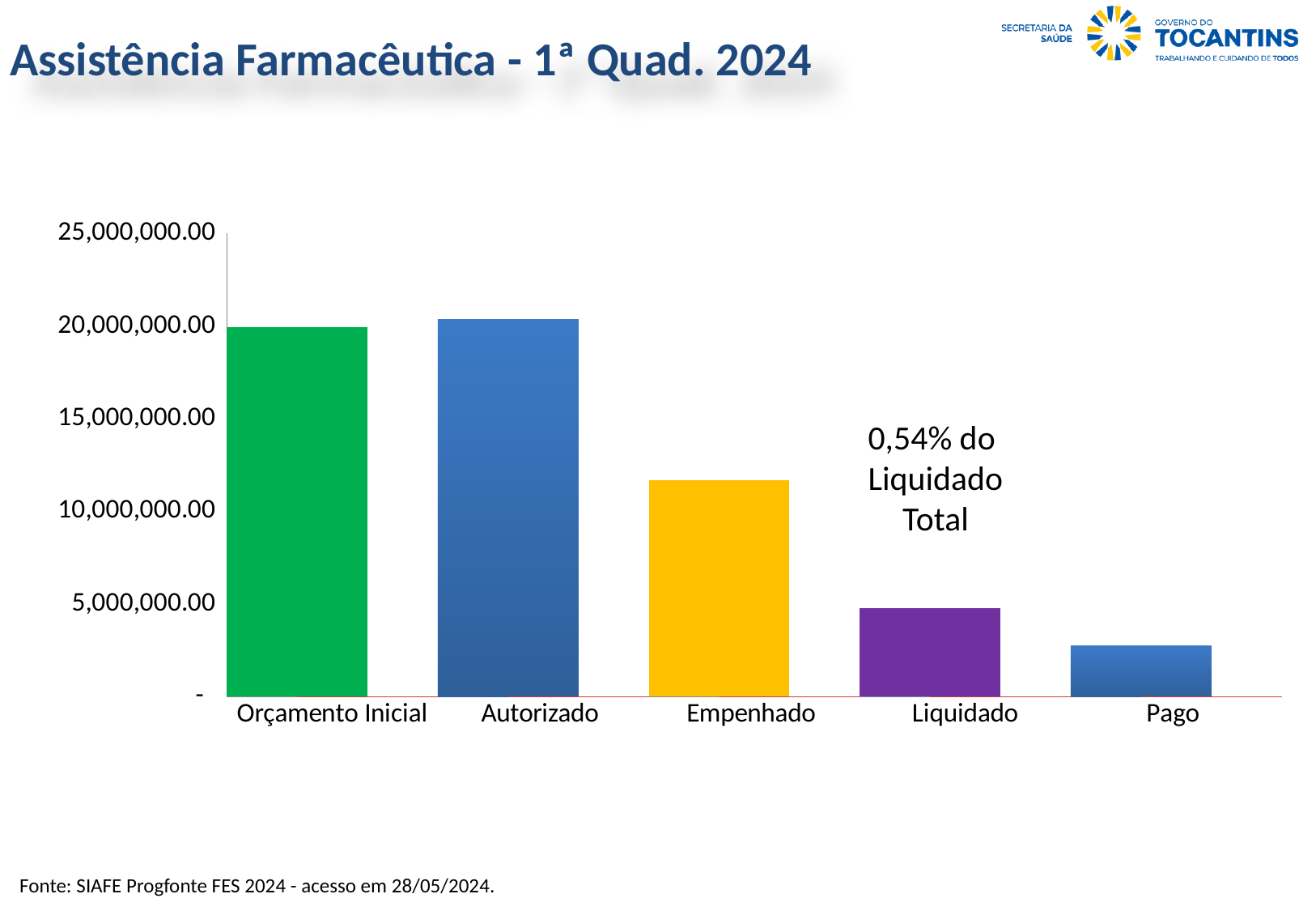
What kind of chart is shown on the slide? bar chart How many categories are plotted on the x axis? 5 Is the value for Pago greater or less than 5,000,000.00? less Which is larger, the value for Empenhado or the value for Liquidado? Empenhado Is the value for Orçamento Inicial greater or less than 15,000,000.00? greater Is the value for Empenhado greater or less than 15,000,000.00? less Which is larger, the value for Pago or the value for Liquidado? Liquidado What is the title of the slide? Assistência Farmacêutica - 1ª Quad. 2024 From Autorizado to Pago, do the values rise or fall along the x axis? fall What percentage is stated in the annotation next to the Liquidado bar? 0,54% Which category has the lowest value? Pago